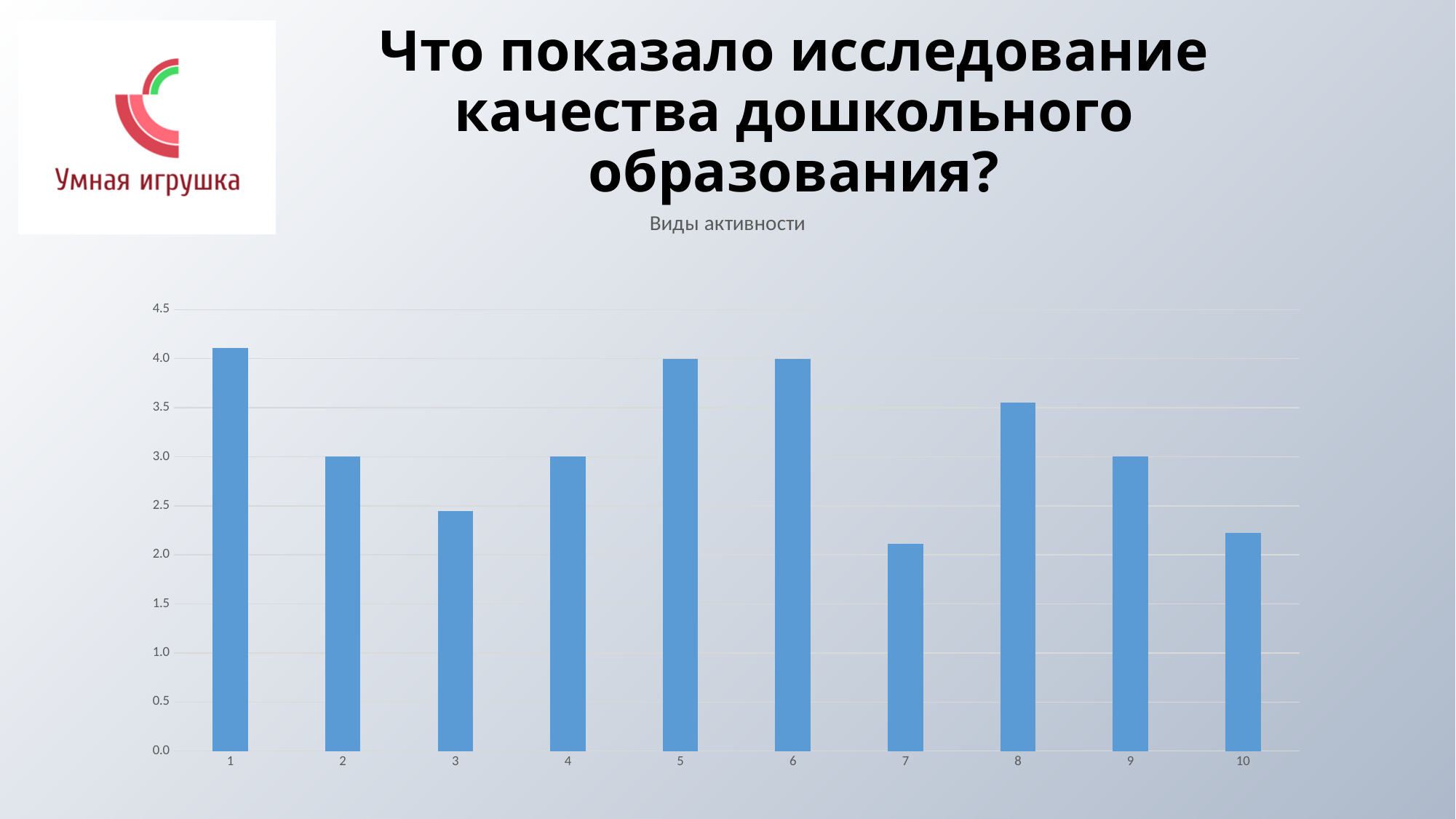
Is the value for category 1 greater or less than 4.0? greater Which has the larger value, category 7 or category 8? category 8 What is the value for category 2? 3.0 Is the value for category 10 greater or less than 2.5? less What is the value for category 9? 3.0 What is the title of the chart? Виды активности What is the value for category 5? 4.0 Which has the larger value, category 1 or category 3? category 1 What kind of chart is shown on the slide? bar chart How many categories are plotted on the x axis of the chart? 10